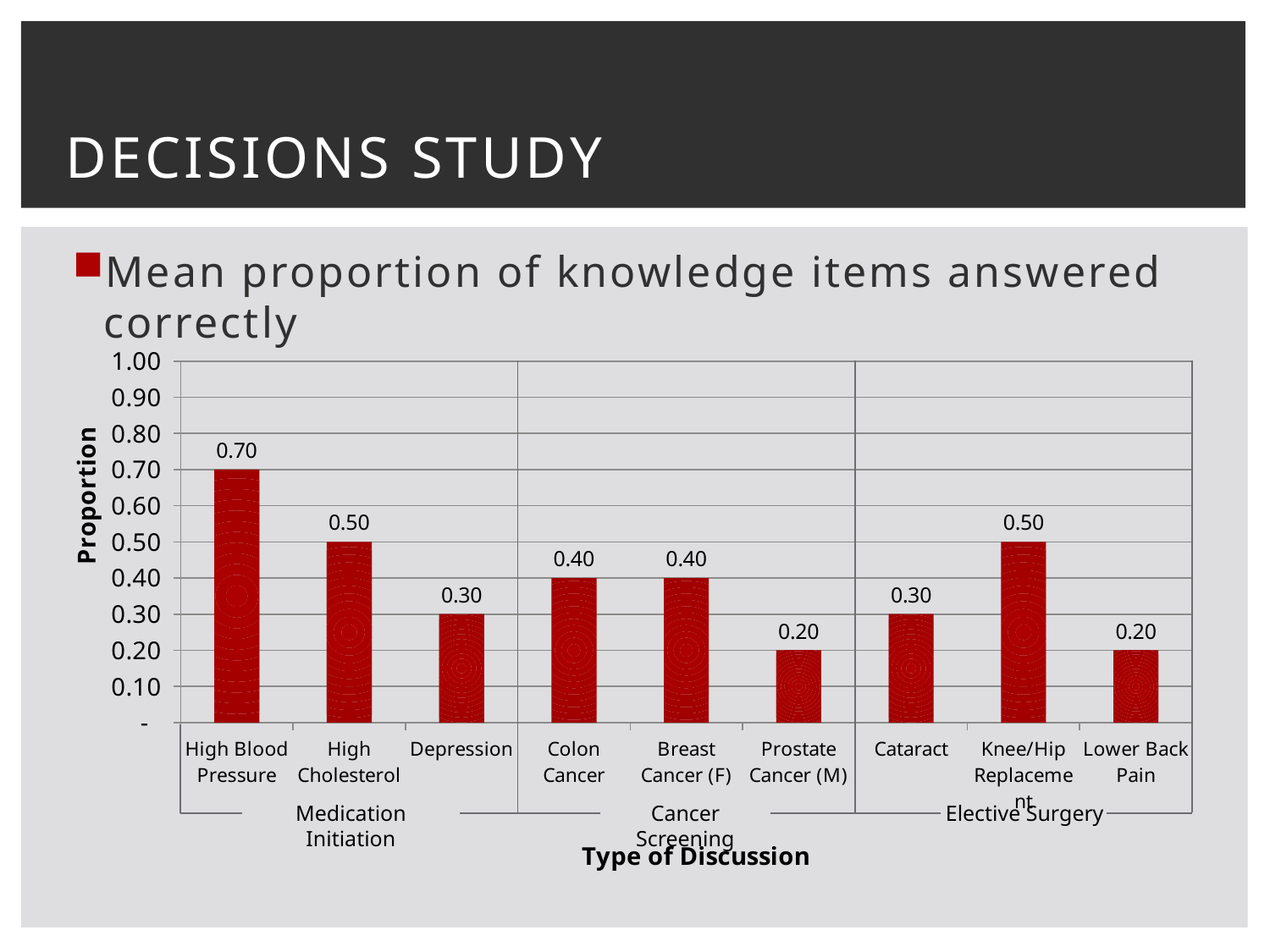
What is the label of the y axis? Proportion What is the value for Prostate Cancer (M)? 0.20 What is the value for Knee/Hip Replacement? 0.50 Which category has the highest value? High Blood Pressure Is the value for Colon Cancer greater or less than 0.50? less What is the difference between the values for High Blood Pressure and Depression? 0.40 How many categories are shown on the x axis? 9 Which is larger, the value for High Cholesterol or the value for Cataract? High Cholesterol What is the label of the x axis? Type of Discussion What kind of chart is this? bar chart What is the value for High Blood Pressure? 0.70 Do the values rise or fall from High Blood Pressure to Depression? fall